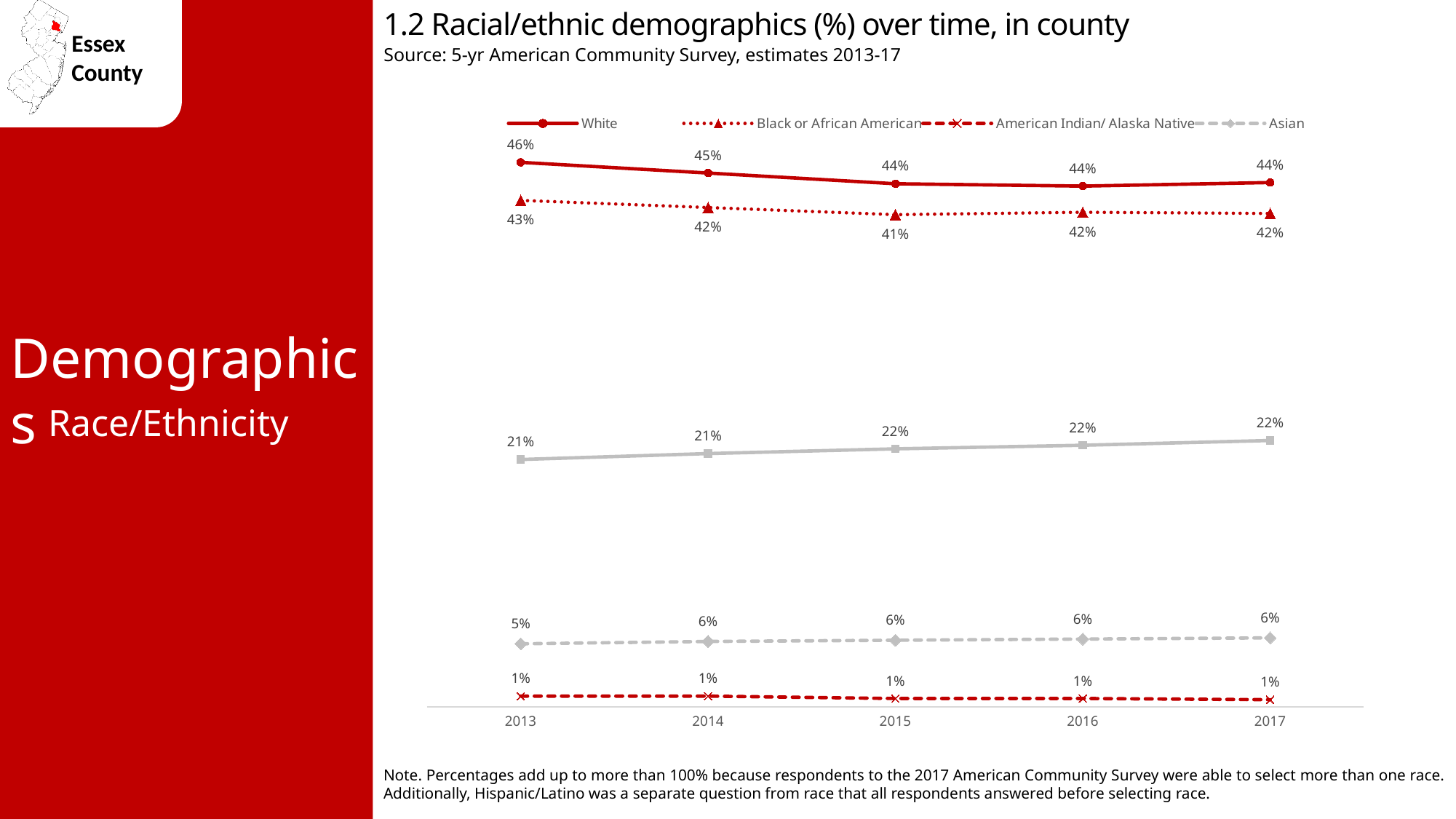
How many years are shown on the x axis? 5 Does the White series rise or fall from 2013 to 2017? Fall What is the value for Black or African American in 2015? 41% Which is larger in 2017, the White value or the Black or African American value? White What kind of chart is shown on the slide? Line chart What is the value for White in 2013? 46% How many series does the legend list? 4 In which year is the White series at its highest? 2013 In which year is the Black or African American series at its lowest? 2015 What is the value for Asian in 2013? 5% What is the difference between the White and Black or African American values in 2013? 3 percentage points What is the value for American Indian/ Alaska Native in 2017? 1%